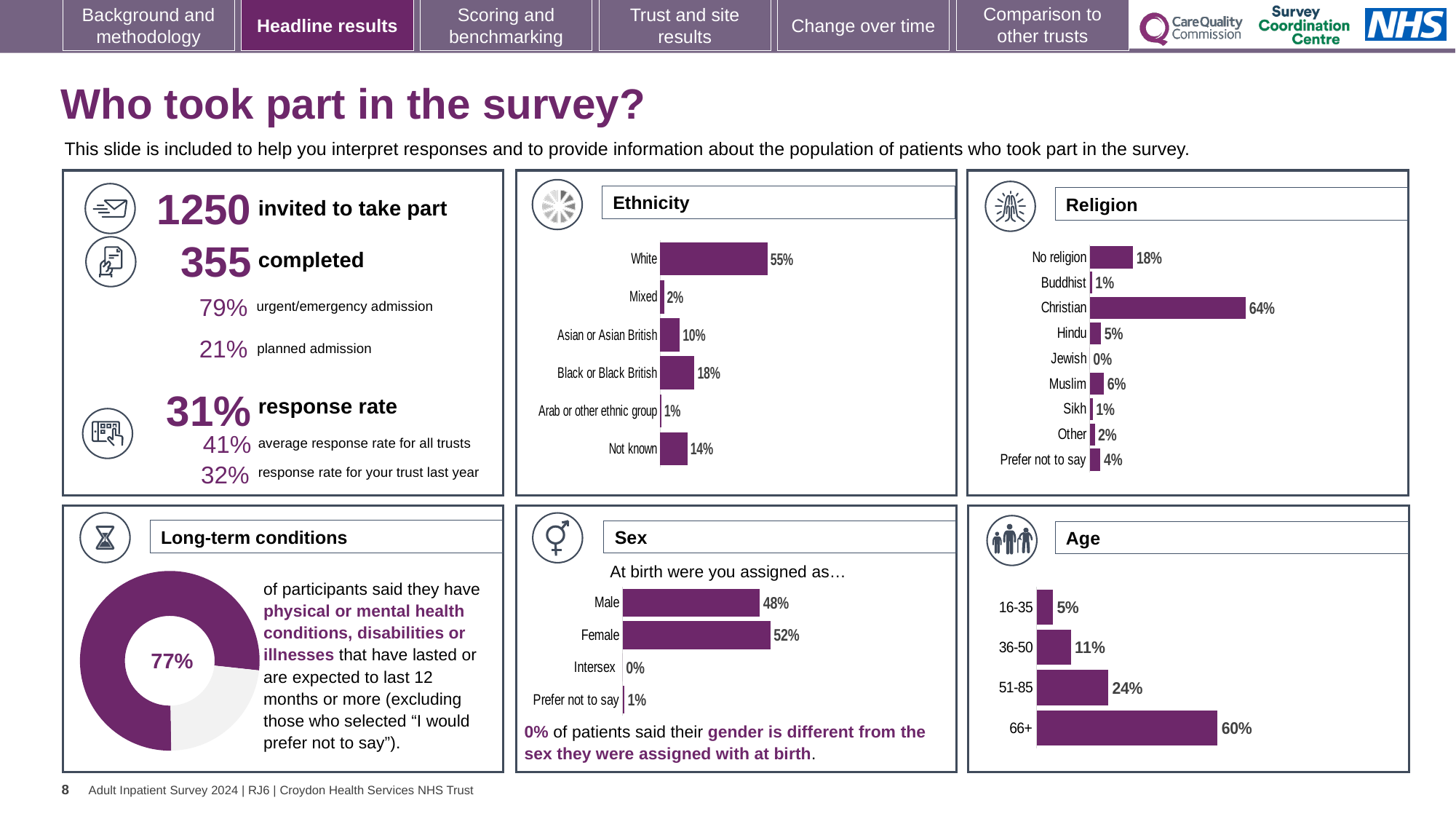
In the Sex chart, which is larger, Male or Female? Female In the Sex chart, what percentage of participants said Prefer not to say? 1% In the Religion chart, what is the difference between the Christian and No religion values? 46% In the Religion chart, which category has the highest value? Christian What kind of chart is used in the Long-term conditions panel? doughnut chart In the Ethnicity chart, how many categories are shown? 6 In the Ethnicity chart, what percentage of participants were White? 55% In the Age chart, do the values rise or fall as age increases from 16-35 to 66+? rise In the Ethnicity chart, which category has the lowest value? Arab or other ethnic group In the Age chart, what percentage of participants were aged 66+? 60% In the Religion chart, how many categories are shown? 9 In the Religion chart, what percentage of participants were Christian? 64%